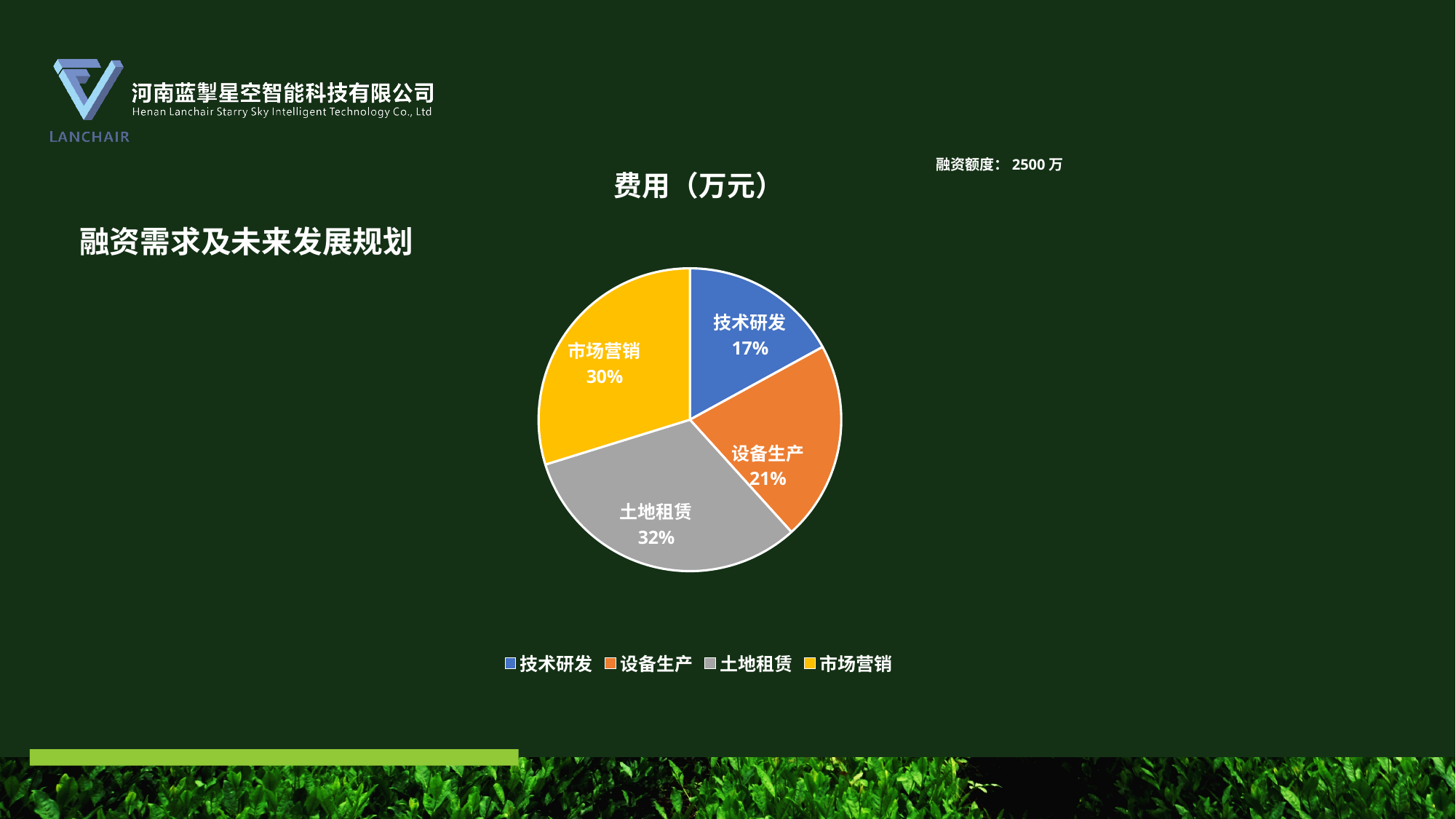
What is the title of the chart? 费用（万元） What is the difference in percentage points between 土地租赁 and 技术研发? 15 What is the difference in percentage points between 市场营销 and 设备生产? 9 Which category has the smallest slice of the pie? 技术研发 How many categories are shown in the pie chart? 4 What share of the pie does 技术研发 represent? 17% What share of the pie does 土地租赁 represent? 32% Which is larger, the share for 设备生产 or the share for 市场营销? 市场营销 What kind of chart is shown on the slide? Pie chart What share of the pie does 市场营销 represent? 30% Which category has the largest slice of the pie? 土地租赁